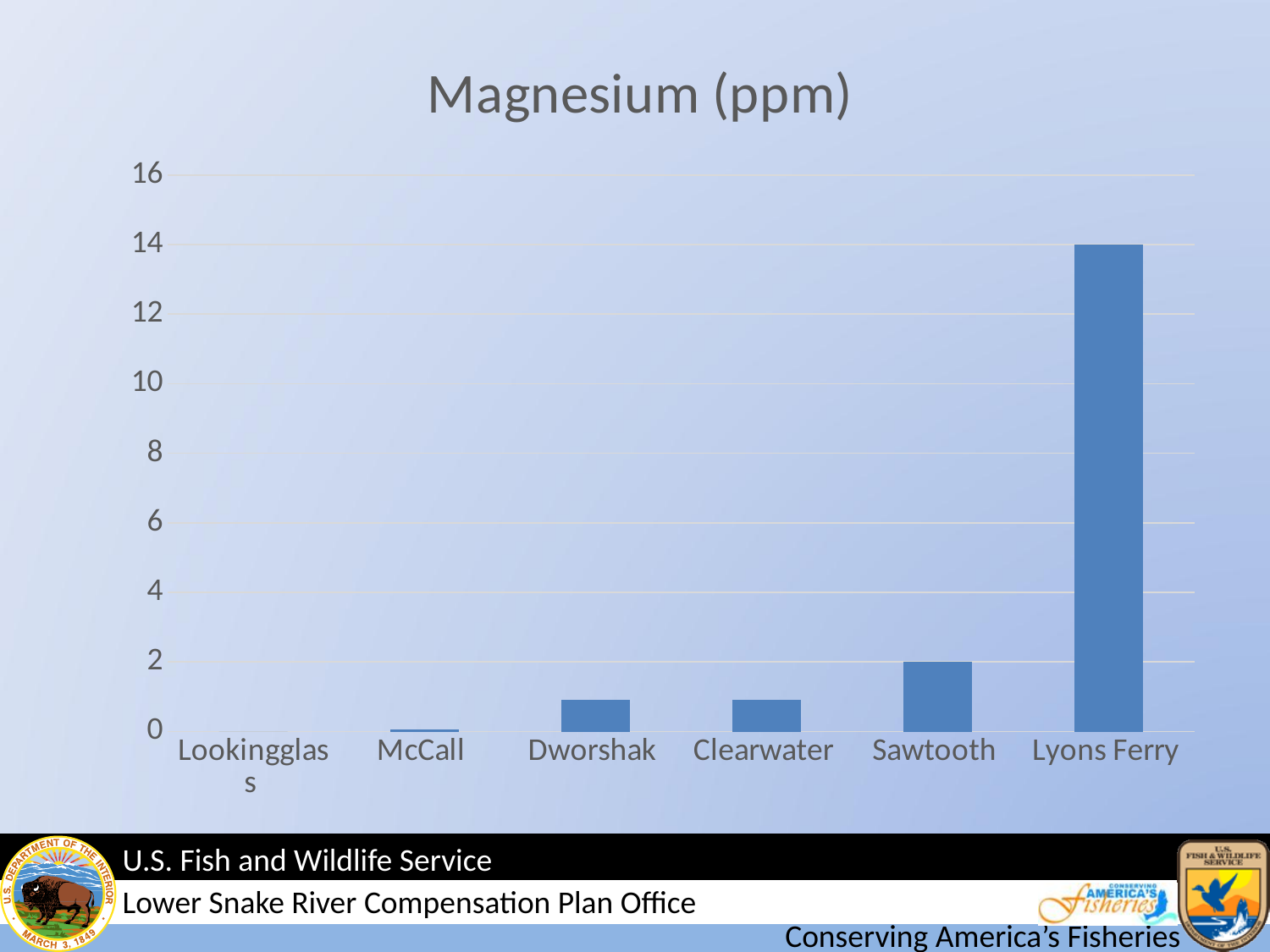
What is the magnesium value for Sawtooth? 2 Is the magnesium value for Lyons Ferry greater or less than 10? greater What is the difference between the magnesium values for Lyons Ferry and Sawtooth? 12 Which hatchery has the highest magnesium value? Lyons Ferry How many hatcheries (categories) are shown on the x axis? 6 Which hatchery has the lowest magnesium value? Lookingglass Do the magnesium values generally rise or fall from left to right across the x axis? rise What kind of chart is shown on the slide? bar chart Is the magnesium value for Dworshak greater or less than 2? less What is the magnesium value for Lyons Ferry? 14 Which has a larger magnesium value, Sawtooth or Clearwater? Sawtooth What is the title of the chart? Magnesium (ppm)